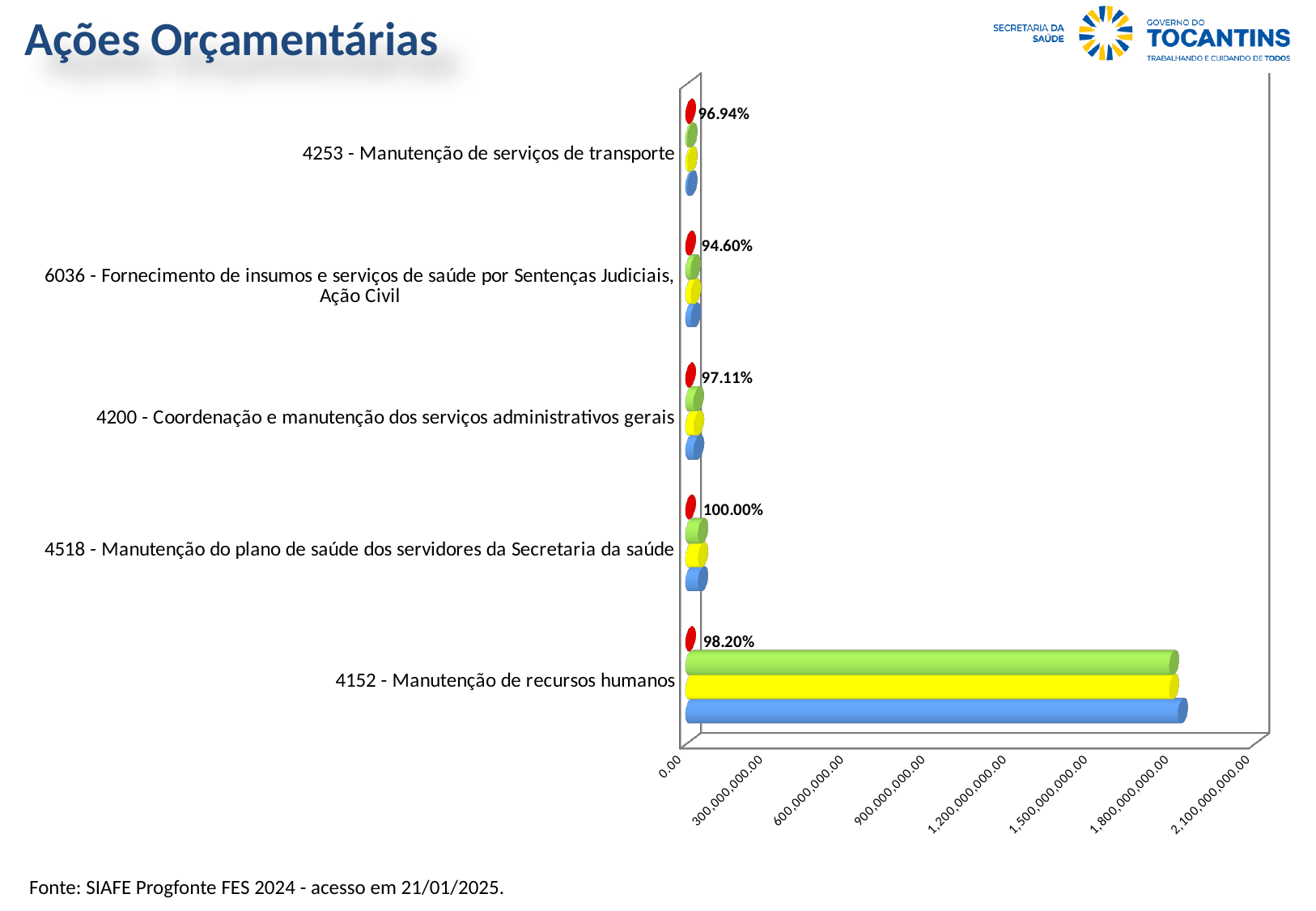
Is the value of the blue bar for 4253 - Manutenção de serviços de transporte greater or less than 300,000,000.00? less What kind of chart is shown on the slide? Bar chart What is the difference between the percentage labels for 4518 - Manutenção do plano de saúde dos servidores da Secretaria da saúde and 6036 - Fornecimento de insumos e serviços de saúde por Sentenças Judiciais, Ação Civil? 5.40% Which has the larger percentage label: 4200 - Coordenação e manutenção dos serviços administrativos gerais or 4253 - Manutenção de serviços de transporte? 4200 - Coordenação e manutenção dos serviços administrativos gerais Which category has the lowest percentage label? 6036 - Fornecimento de insumos e serviços de saúde por Sentenças Judiciais, Ação Civil Is the value of the blue bar for 4152 - Manutenção de recursos humanos greater or less than 1,500,000,000.00? greater How many categories (budget actions) are shown on the chart? 5 What percentage label is shown for 6036 - Fornecimento de insumos e serviços de saúde por Sentenças Judiciais, Ação Civil? 94.60% What percentage label is shown for 4152 - Manutenção de recursos humanos? 98.20% Which category has the highest percentage label? 4518 - Manutenção do plano de saúde dos servidores da Secretaria da saúde What percentage label is shown for 4200 - Coordenação e manutenção dos serviços administrativos gerais? 97.11% What percentage label is shown for 4253 - Manutenção de serviços de transporte? 96.94%